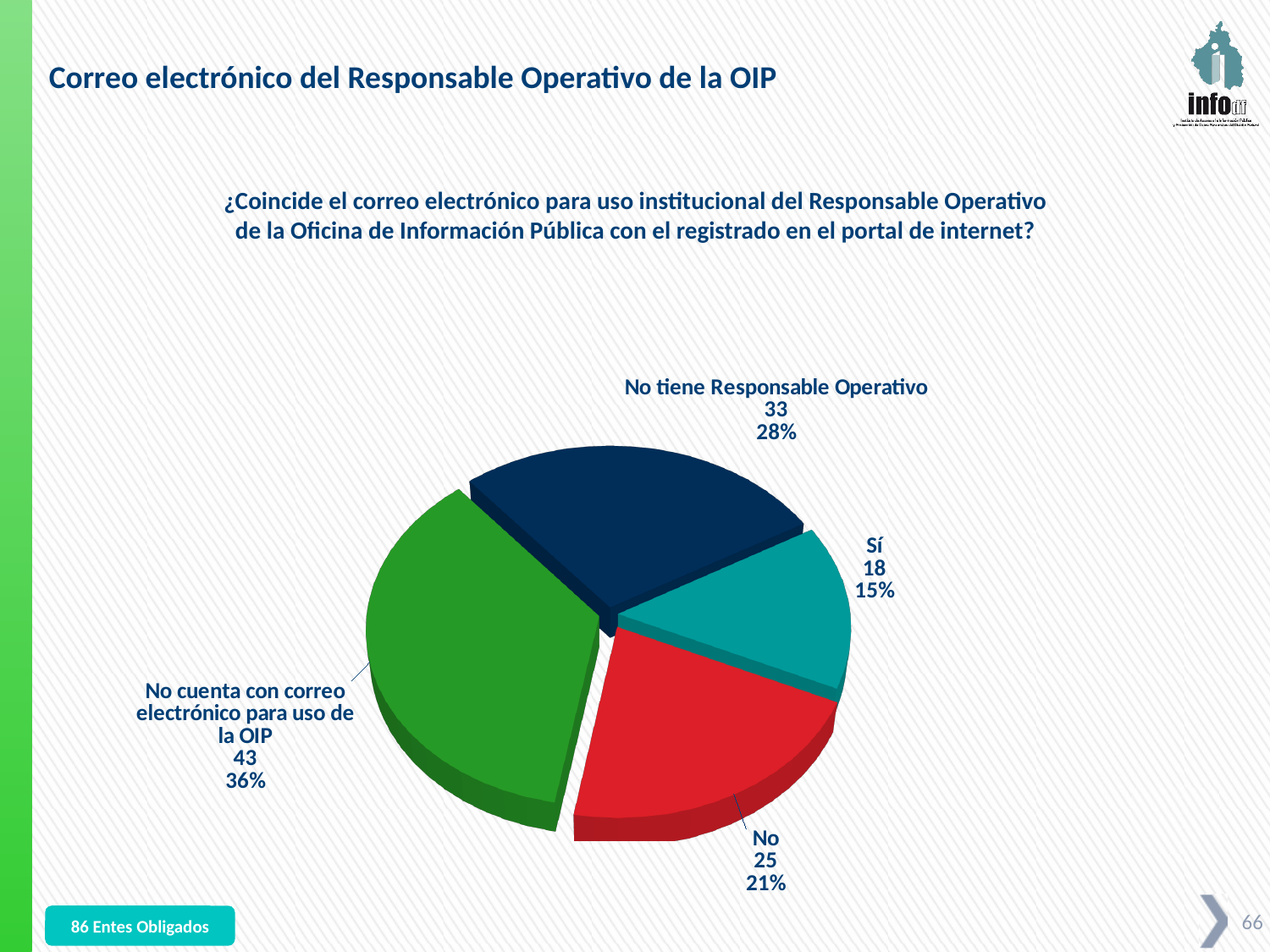
How many slices does the pie chart have? 4 What percentage share does the 'Sí' slice have? 15% What is the value for the 'Sí' slice? 18 Which is larger, the value for 'No' or the value for 'Sí'? No What kind of chart is shown on the slide? pie chart What is the value for 'No tiene Responsable Operativo'? 33 Which category has the largest slice? No cuenta con correo electrónico para uso de la OIP Which category has the smallest slice? Sí What is the difference between the values for 'No cuenta con correo electrónico para uso de la OIP' and 'No tiene Responsable Operativo'? 10 What percentage share does 'No cuenta con correo electrónico para uso de la OIP' have? 36% What is the value for the 'No' slice? 25 What colour is the 'No' slice? red